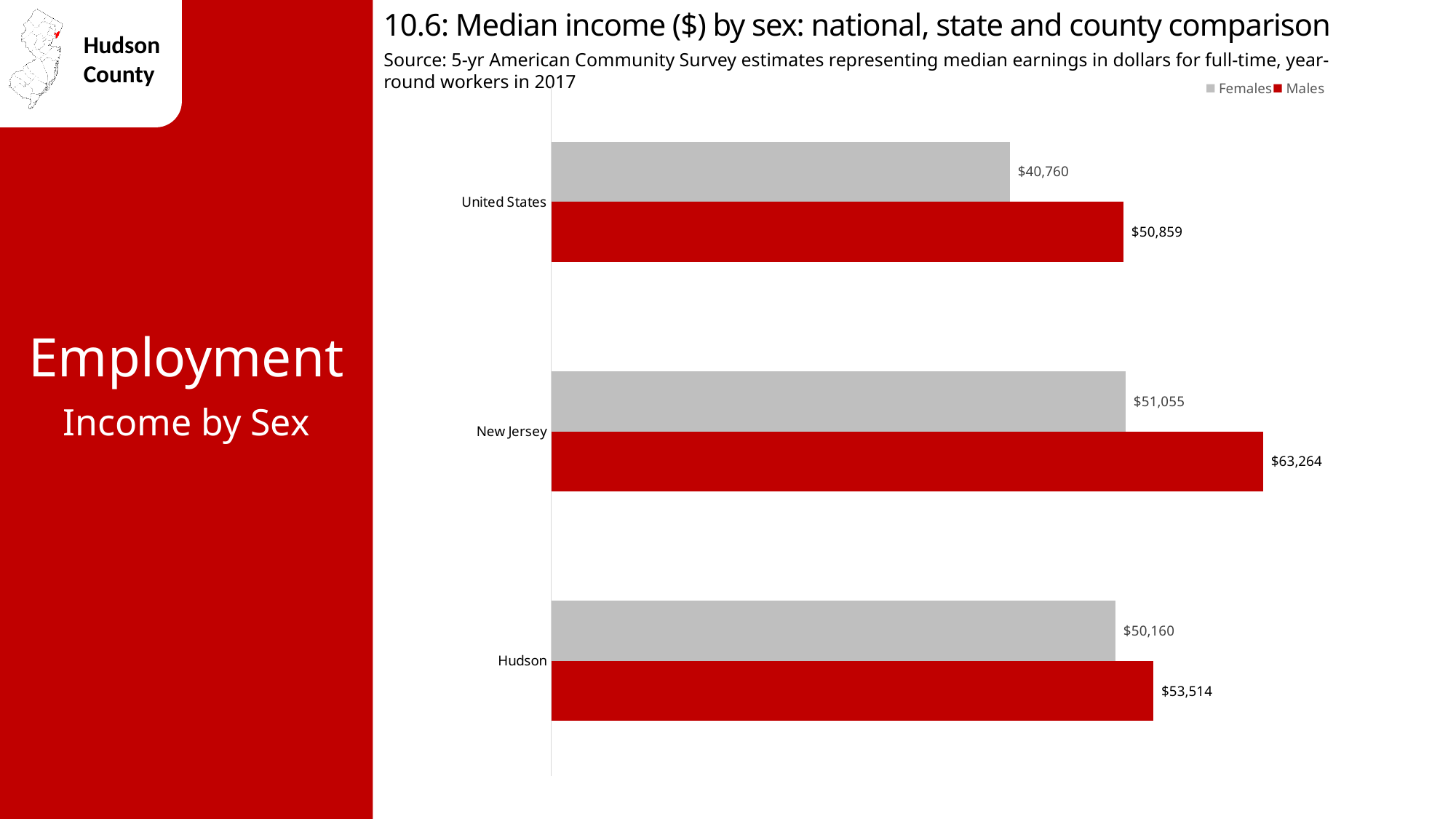
Which is larger: the female median income in New Jersey or the male median income in the United States? Female median income in New Jersey How many series does the legend list? 2 What is the median income for males in Hudson? $53,514 How many geographies are shown on the chart? 3 What is the median income for males in New Jersey? $63,264 What is the difference between male and female median income in Hudson? $3,354 What is the median income for females in the United States? $40,760 Which geography has the lowest median income for females? United States What is the difference between male and female median income in New Jersey? $12,209 Which geography has the highest median income for males? New Jersey What kind of chart is shown on the slide? Bar chart What is the median income for females in Hudson? $50,160